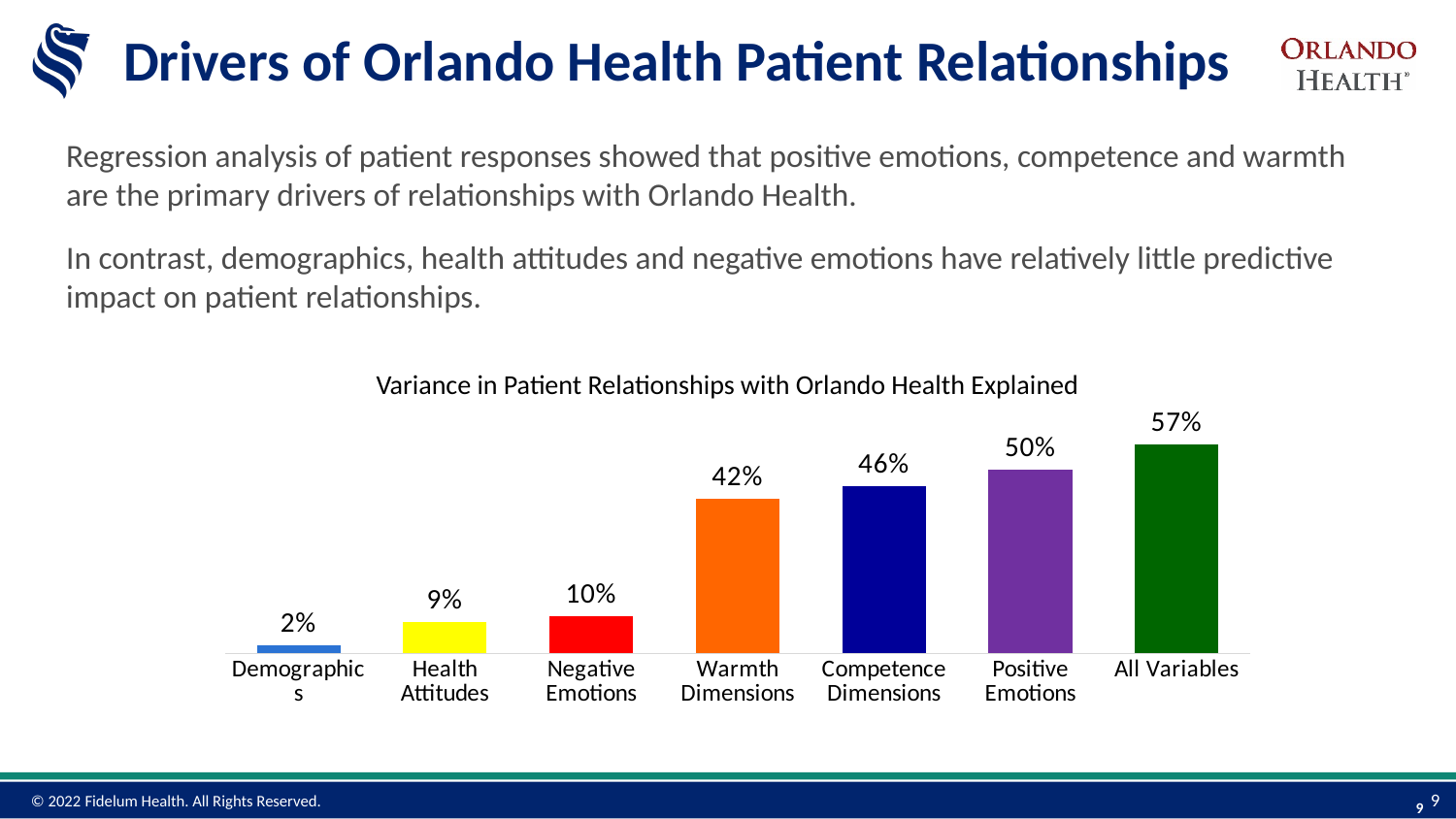
What kind of chart is shown on the slide? Bar chart What is the value for Health Attitudes? 9% What is the title of the chart? Variance in Patient Relationships with Orlando Health Explained Which is larger, the value for Negative Emotions or the value for Health Attitudes? Negative Emotions Which category has the lowest value? Demographics What is the difference between the values for Competence Dimensions and Warmth Dimensions? 4% Which category has the highest value? All Variables What is the value for Positive Emotions? 50% How many categories are shown in the chart? 7 Do the values rise or fall from left to right along the x axis? Rise What is the difference between the values for All Variables and Positive Emotions? 7% What is the value for Warmth Dimensions? 42%